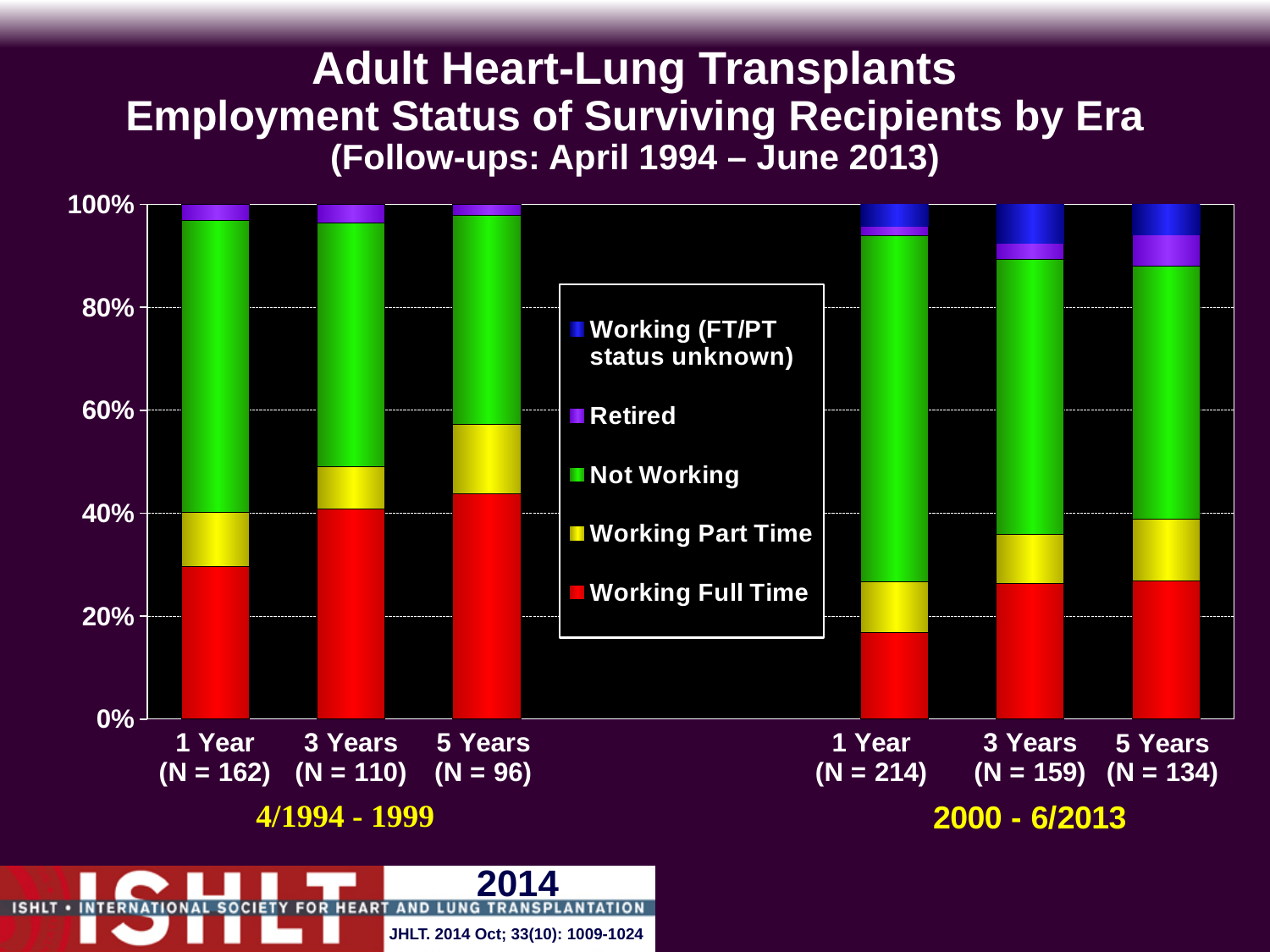
Which is larger: the Working Full Time share at 5 Years in the 4/1994 - 1999 era or at 1 Year in the 2000 - 6/2013 era? 5 Years in the 4/1994 - 1999 era How many series does the legend list? 5 How many bars are plotted in the chart? 6 Which bar has the largest Working Full Time segment? 5 Years (4/1994 - 1999) Is the Working Full Time value for 3 Years in the 2000 - 6/2013 era greater or less than 40%? less Within the 4/1994 - 1999 era, does the Working Full Time share rise or fall from 1 Year to 5 Years? rise Is the Working Full Time value for 1 Year in the 2000 - 6/2013 era greater or less than 20%? less What is the N for the 1 Year bar in the 2000 - 6/2013 era? N = 214 What kind of chart is shown on the slide? Stacked bar chart Which bar has the smallest Working Full Time segment? 1 Year (2000 - 6/2013) Is the Working Full Time value for 1 Year in the 4/1994 - 1999 era greater or less than 20%? greater